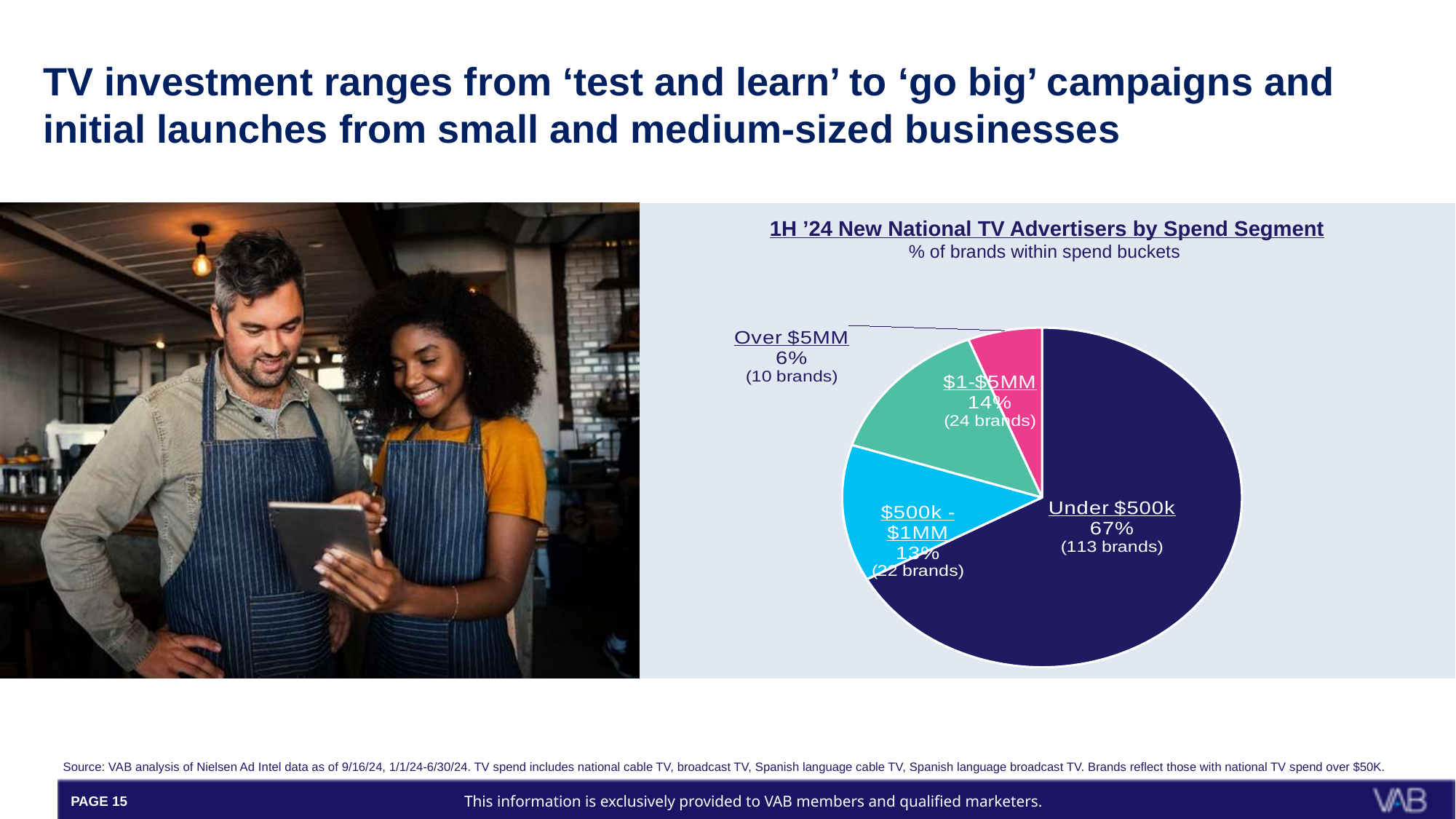
What is the title of the chart? 1H '24 New National TV Advertisers by Spend Segment How many brands are in the $1-$5MM spend segment? 24 brands What percentage of brands fall in the Under $500k spend segment? 67% How many brands are in the $500k - $1MM spend segment? 22 brands How many spend segments are shown in the pie chart? 4 How many more brands are in the Under $500k segment than in the Over $5MM segment? 103 brands What is the difference in percentage points between the Under $500k segment and the $1-$5MM segment? 53 percentage points What kind of chart is shown on the slide? Pie chart Which spend segment has the largest share of brands? Under $500k What percentage of brands are in the Over $5MM spend segment? 6% Which spend segment has the smallest share of brands? Over $5MM Which segment has a larger share of brands, $1-$5MM or Over $5MM? $1-$5MM